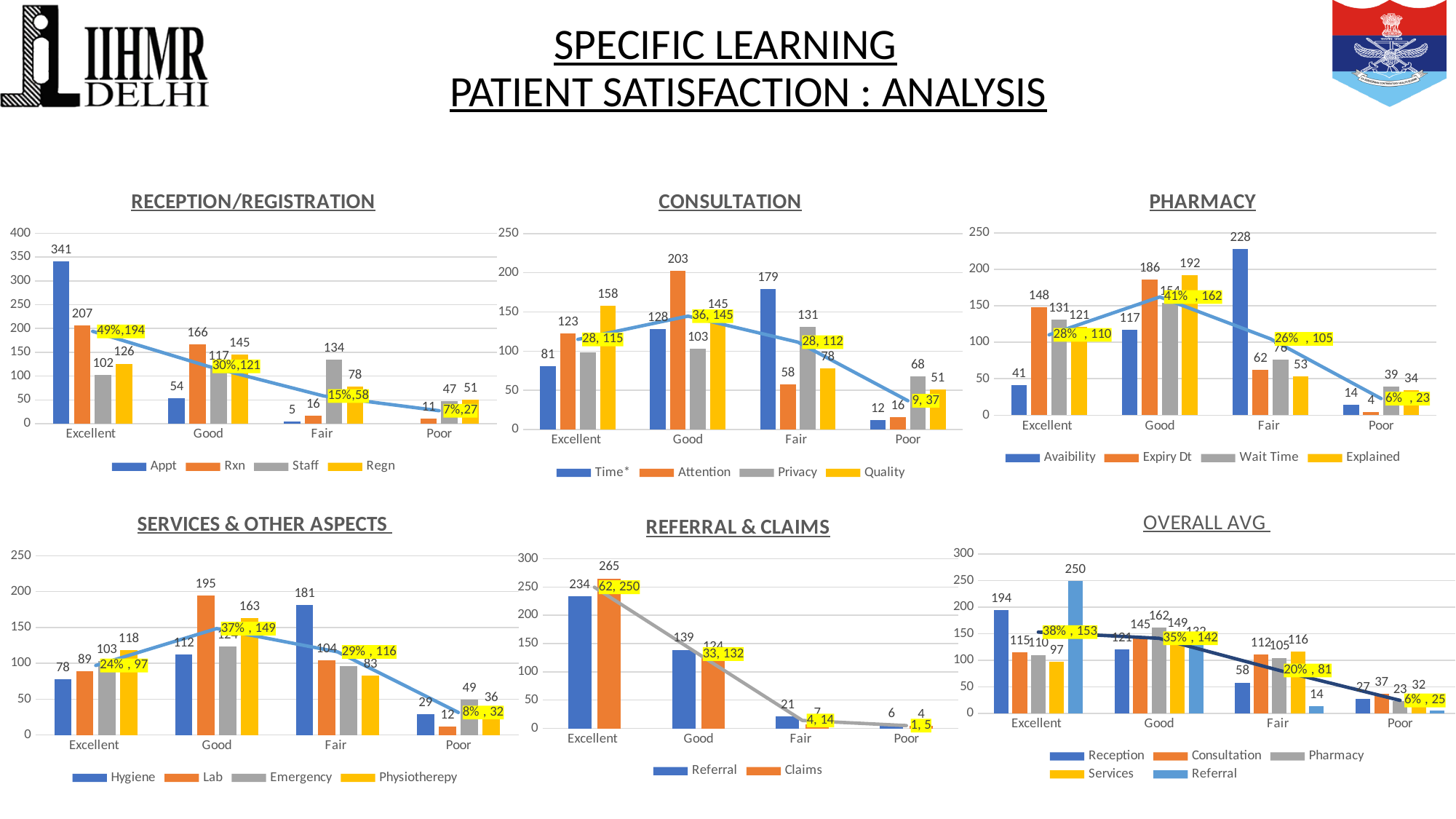
In the OVERALL AVG chart, which series has the highest value for Excellent? Referral In the SERVICES & OTHER ASPECTS chart, which is larger for Good: Lab or Hygiene? Lab In the SERVICES & OTHER ASPECTS chart, how many series does the legend list? 4 In the PHARMACY chart, which category has the highest Avaibility value? Fair In the CONSULTATION chart, what is the difference between Time* for Fair and Attention for Fair? 121 In the REFERRAL & CLAIMS chart, do the Referral values rise or fall from Excellent to Poor? fall In the CONSULTATION chart, what is the value of Attention for Good? 203 In the REFERRAL & CLAIMS chart, what is the value of Claims for Excellent? 265 In the OVERALL AVG chart, how many series does the legend list? 5 In the PHARMACY chart, what is the value of Explained for Good? 192 In the RECEPTION/REGISTRATION chart, which series has the highest value for Fair? Staff In the RECEPTION/REGISTRATION chart, what is the value of Appt for Excellent? 341